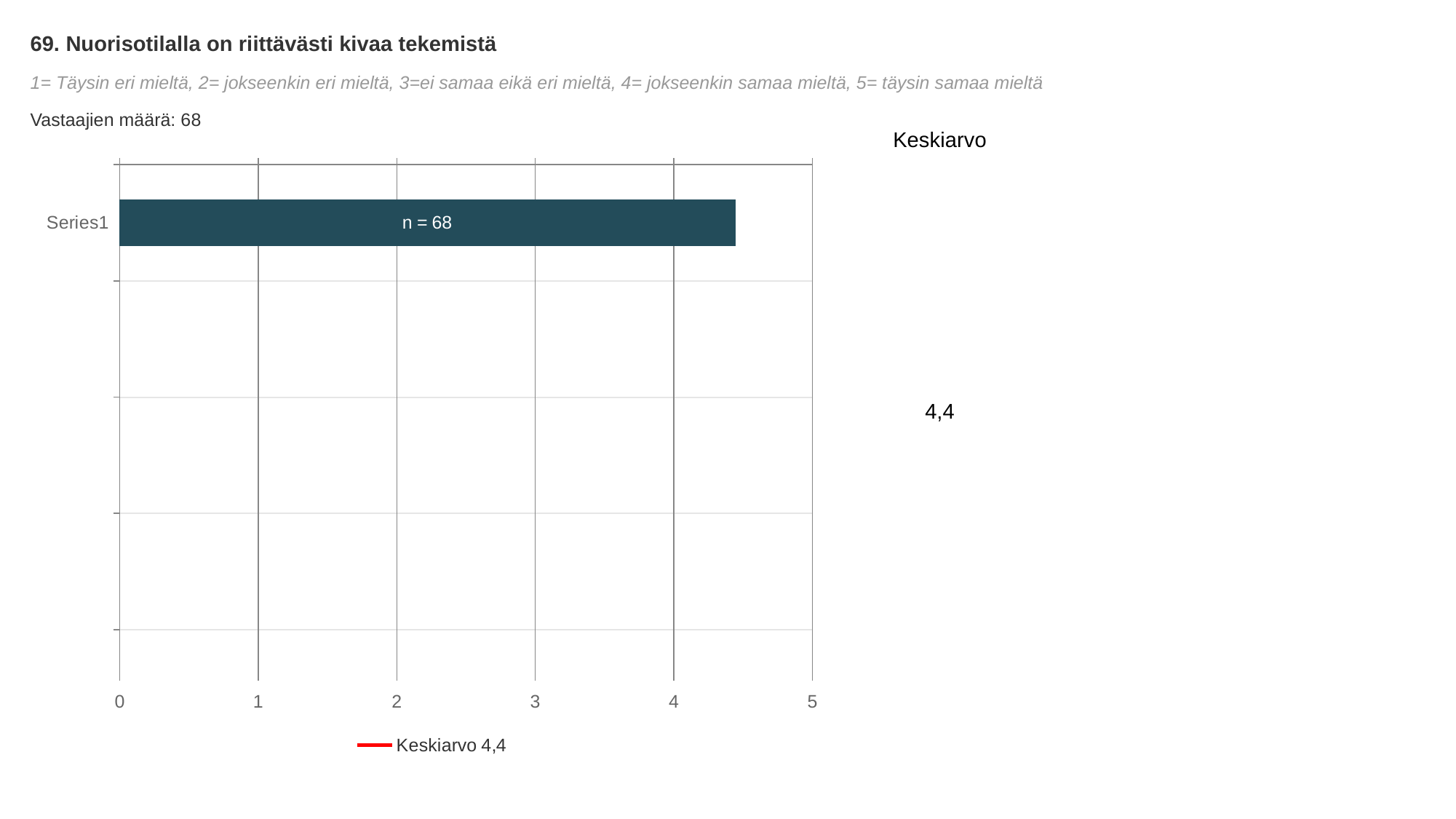
How many entries does the chart legend list? 1 What is the highest value shown on the x axis? 5 What is the Keskiarvo (mean) value shown for the chart? 4,4 What data label is printed on the Series1 bar? n = 68 Is the value for Series1 greater or less than 4? greater How many bars are plotted in the chart? 1 What is the title of the chart on the slide? 69. Nuorisotilalla on riittävästi kivaa tekemistä Is the value for Series1 greater or less than 5? less What kind of chart is shown on the slide? bar chart What is the label of the only category on the y axis? Series1 Is the value for Series1 greater or less than 3? greater